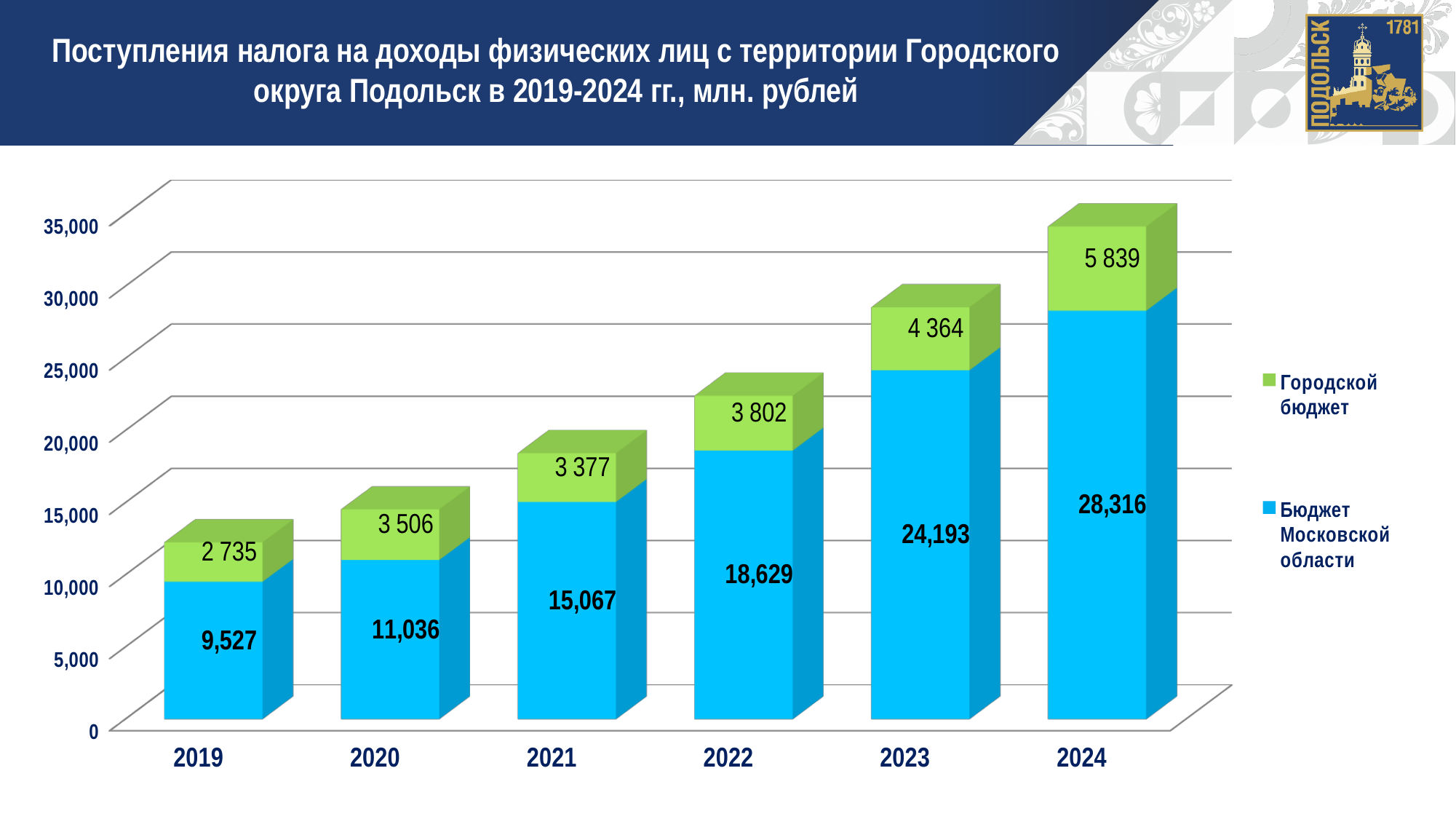
What is the value for Городской бюджет in 2019? 2 735 What is the value for Бюджет Московской области in 2024? 28,316 What is the difference between the Бюджет Московской области values for 2023 and 2022? 5,564 How many years are shown on the x axis? 6 What kind of chart is shown on the slide? Stacked bar chart What is the total of the stacked bar for 2019? 12,262 How many series does the legend list? 2 Which is larger: the Городской бюджет value for 2020 or for 2021? 2020 Which year has the lowest value for Городской бюджет? 2019 What is the value for Городской бюджет in 2022? 3 802 Which year has the highest value for Бюджет Московской области? 2024 Do the Бюджет Московской области values rise or fall from 2019 to 2024? Rise